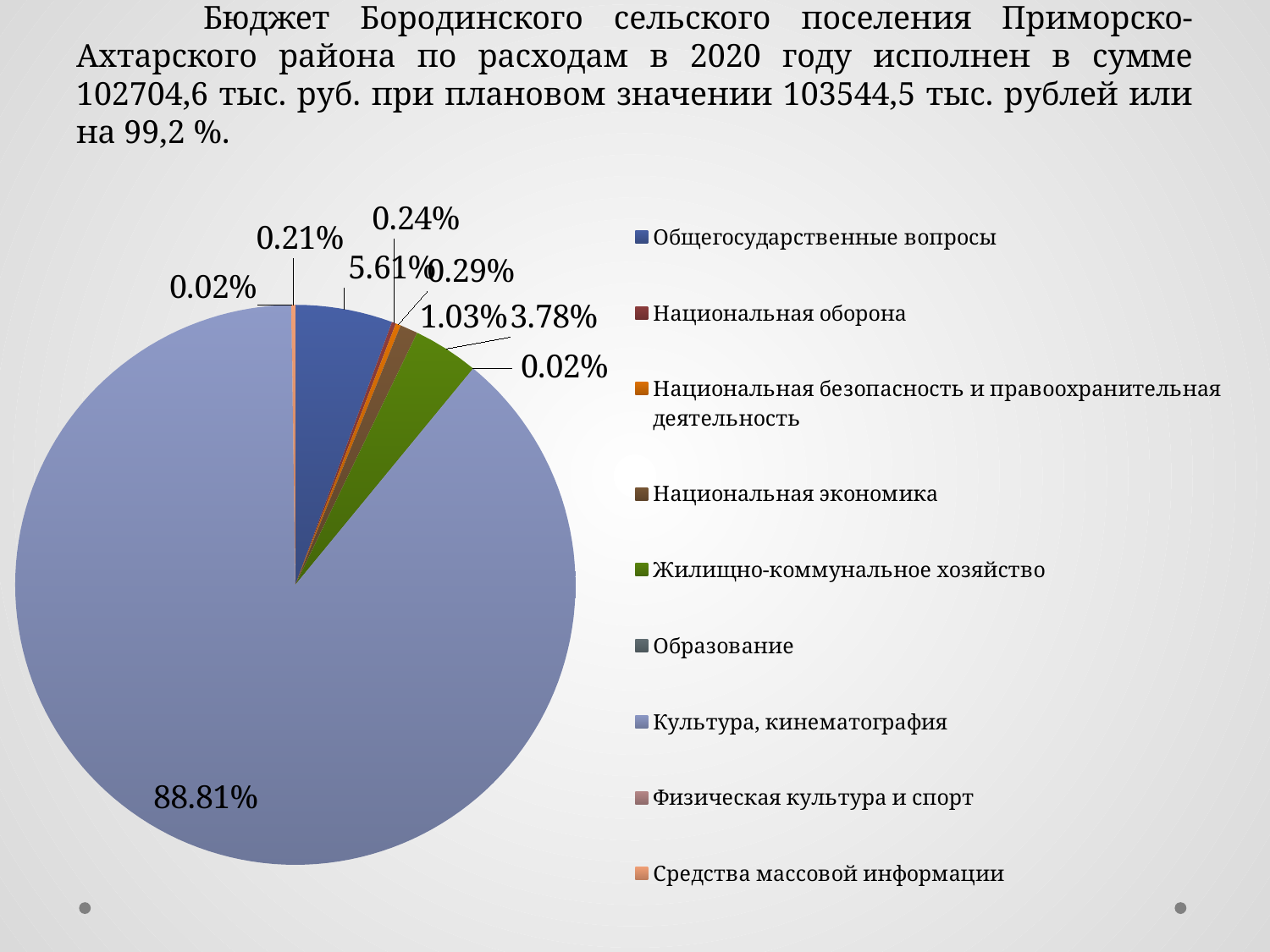
What is the smallest percentage value labelled on the pie chart? 0.02% What kind of chart is shown on the slide? pie chart How many categories does the legend of the pie chart list? 9 What share of the pie does Культура, кинематография have? 88.81% Which is larger: the share for Общегосударственные вопросы or for Жилищно-коммунальное хозяйство? Общегосударственные вопросы What is the value shown for Жилищно-коммунальное хозяйство? 3.78% Which category has the largest share of the pie chart? Культура, кинематография What is the value shown for Национальная экономика? 1.03% What is the difference between the share for Общегосударственные вопросы and the share for Жилищно-коммунальное хозяйство? 1.83% What is the difference between the share for Культура, кинематография and the share for Общегосударственные вопросы? 83.20% What is the value shown for Общегосударственные вопросы? 5.61% According to the slide text, what percentage of the planned budget was executed in 2020? 99,2 %